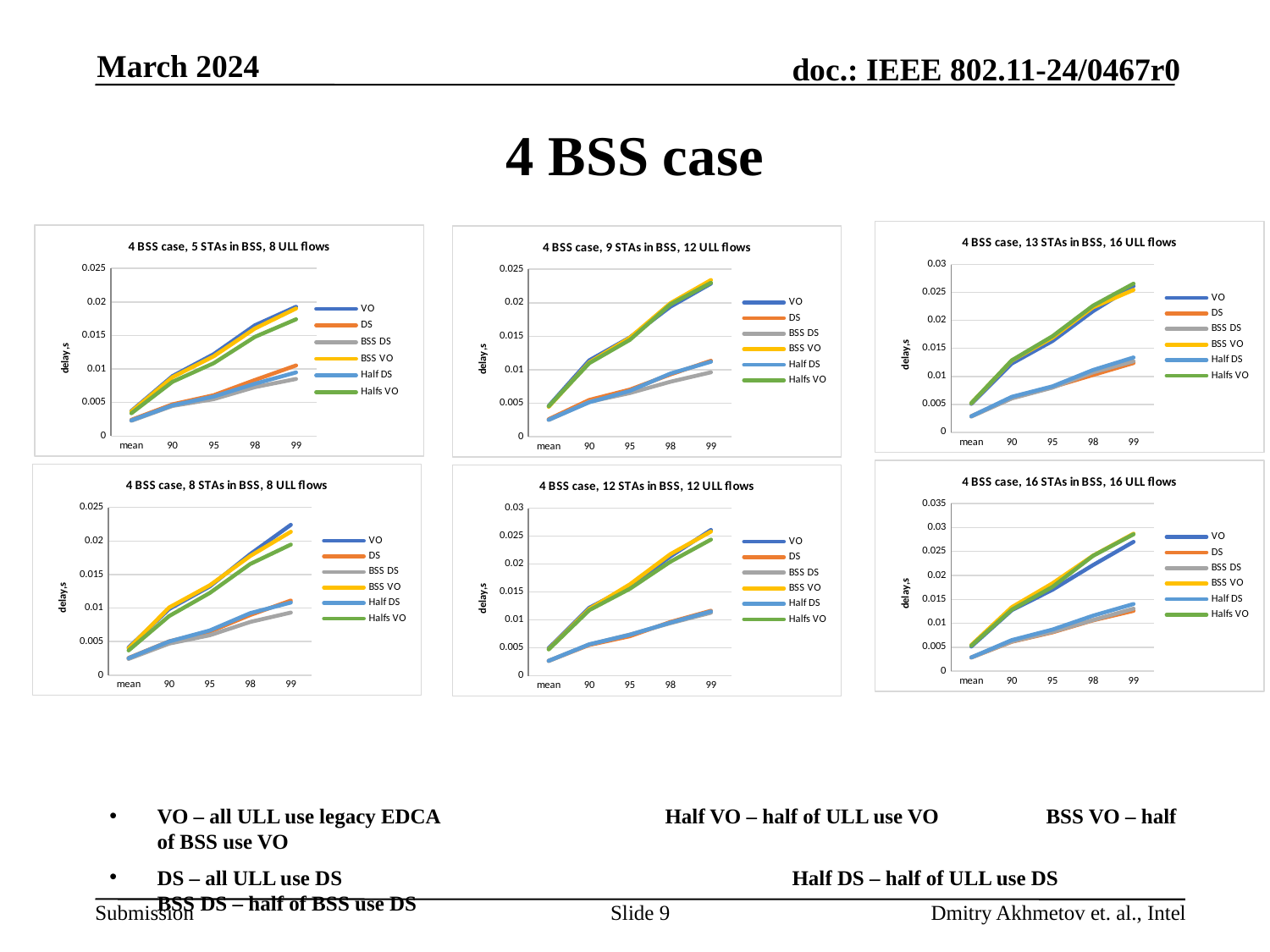
In the chart '4 BSS case, 16 STAs in BSS, 16 ULL flows', is the Halfs VO value at 99 greater or less than 0.025? greater In the chart '4 BSS case, 13 STAs in BSS, 16 ULL flows', what is the last entry in the legend? Halfs VO What kind of chart is '4 BSS case, 5 STAs in BSS, 8 ULL flows'? line chart What is the y-axis label of the chart '4 BSS case, 12 STAs in BSS, 12 ULL flows'? delay,s In the chart '4 BSS case, 8 STAs in BSS, 8 ULL flows', do the VO values rise or fall from 'mean' to '99'? rise In the chart '4 BSS case, 9 STAs in BSS, 12 ULL flows', which is larger at 'mean': VO or Half DS? VO In the chart '4 BSS case, 13 STAs in BSS, 16 ULL flows', is the Half DS value at 99 greater or less than 0.01? greater In the chart '4 BSS case, 9 STAs in BSS, 12 ULL flows', how many categories are on the x axis? 5 In the chart '4 BSS case, 5 STAs in BSS, 8 ULL flows', is the VO value at 99 greater or less than 0.015? greater In the chart '4 BSS case, 5 STAs in BSS, 8 ULL flows', how many series does the legend list? 6 In the chart '4 BSS case, 16 STAs in BSS, 16 ULL flows', which is larger at 99: VO or DS? VO